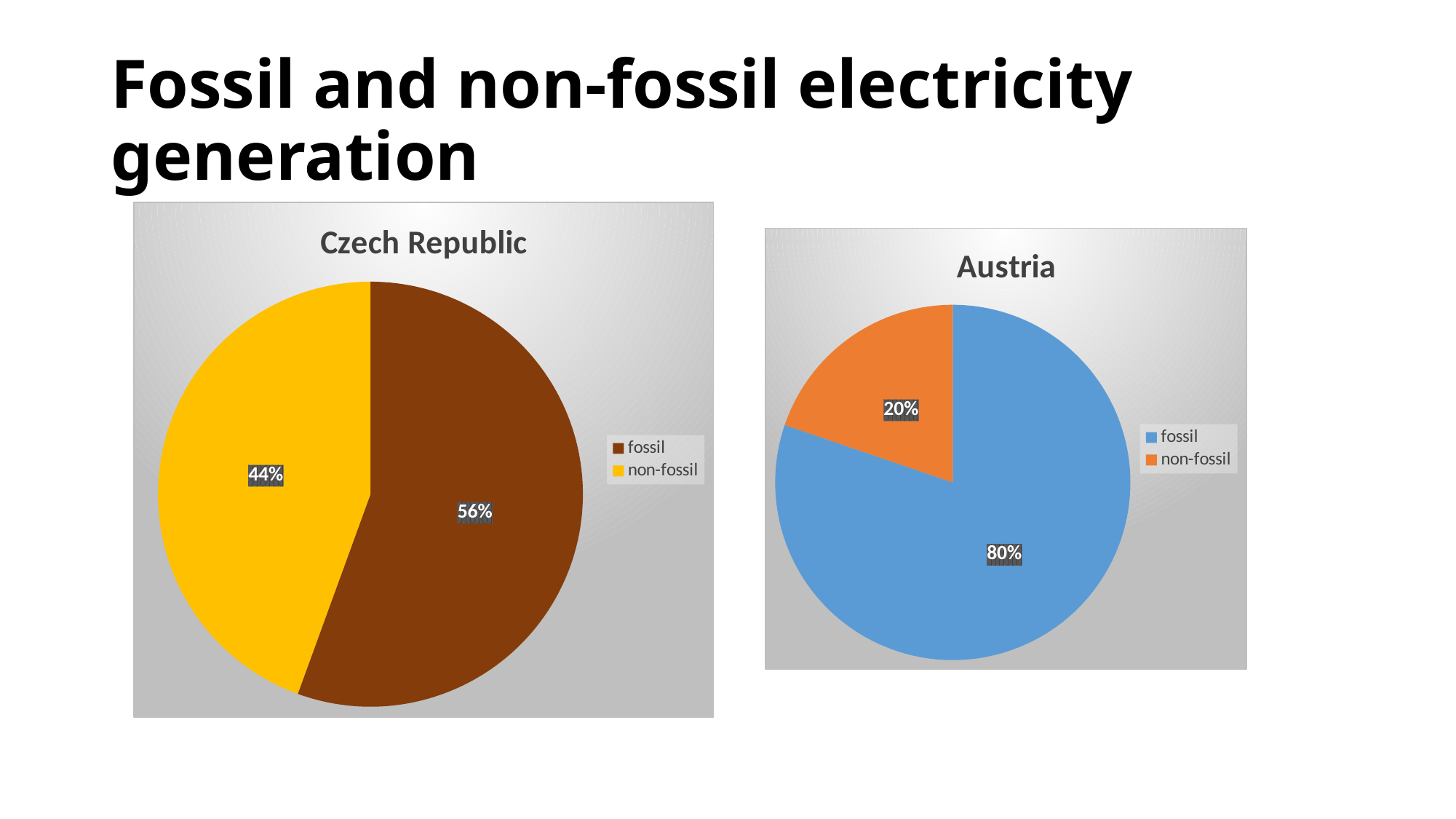
How many slices does the Austria pie chart have? 2 In the Czech Republic chart, which slice is the largest? fossil What type of chart is used for the Czech Republic? pie chart In the Austria chart, what share of electricity generation is fossil? 80% In the Czech Republic chart, what is the difference between the fossil and non-fossil shares? 12% In the Czech Republic chart, what share of electricity generation is fossil? 56% In the Austria chart, which slice is the smallest? non-fossil In the Austria chart, what share of electricity generation is non-fossil? 20% In the Austria chart, what is the difference between the fossil and non-fossil shares? 60% In the Austria chart, what colour is the fossil slice? blue Which chart shows a larger fossil share, Czech Republic or Austria? Austria In the Czech Republic chart, what share of electricity generation is non-fossil? 44%